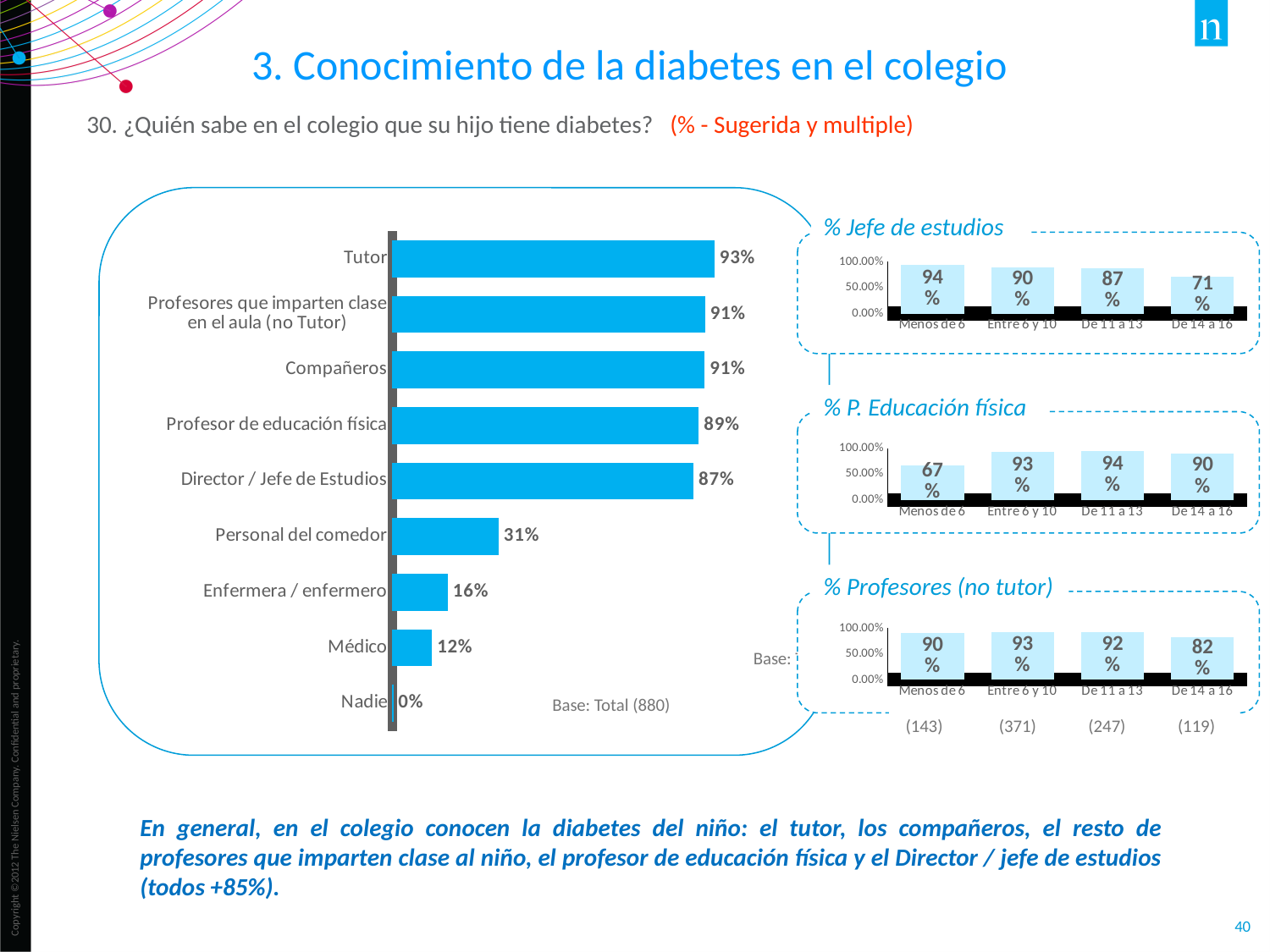
In the '% Profesores (no tutor)' chart, what is the difference between the values for Entre 6 y 10 and De 14 a 16? 11% How many categories does the main bar chart on the left show? 9 In the main bar chart on the left, what percentage is shown for Personal del comedor? 31% In the '% P. Educación física' chart, which age group has the lowest value? Menos de 6 In the '% Jefe de estudios' chart, what is the value for De 14 a 16? 71% In the main bar chart on the left, which category has the lowest value? Nadie What kind of chart is the main chart on the left? Bar chart In the '% Jefe de estudios' chart, do the values rise or fall from Menos de 6 to De 14 a 16? Fall What base (total) is stated for the main bar chart on the left? Base: Total (880) In the main bar chart on the left, what percentage is shown for Tutor? 93% In the main bar chart on the left, what is the difference between the values for Tutor and Médico? 81% In the main bar chart on the left, which is larger: the value for Enfermera / enfermero or the value for Médico? Enfermera / enfermero